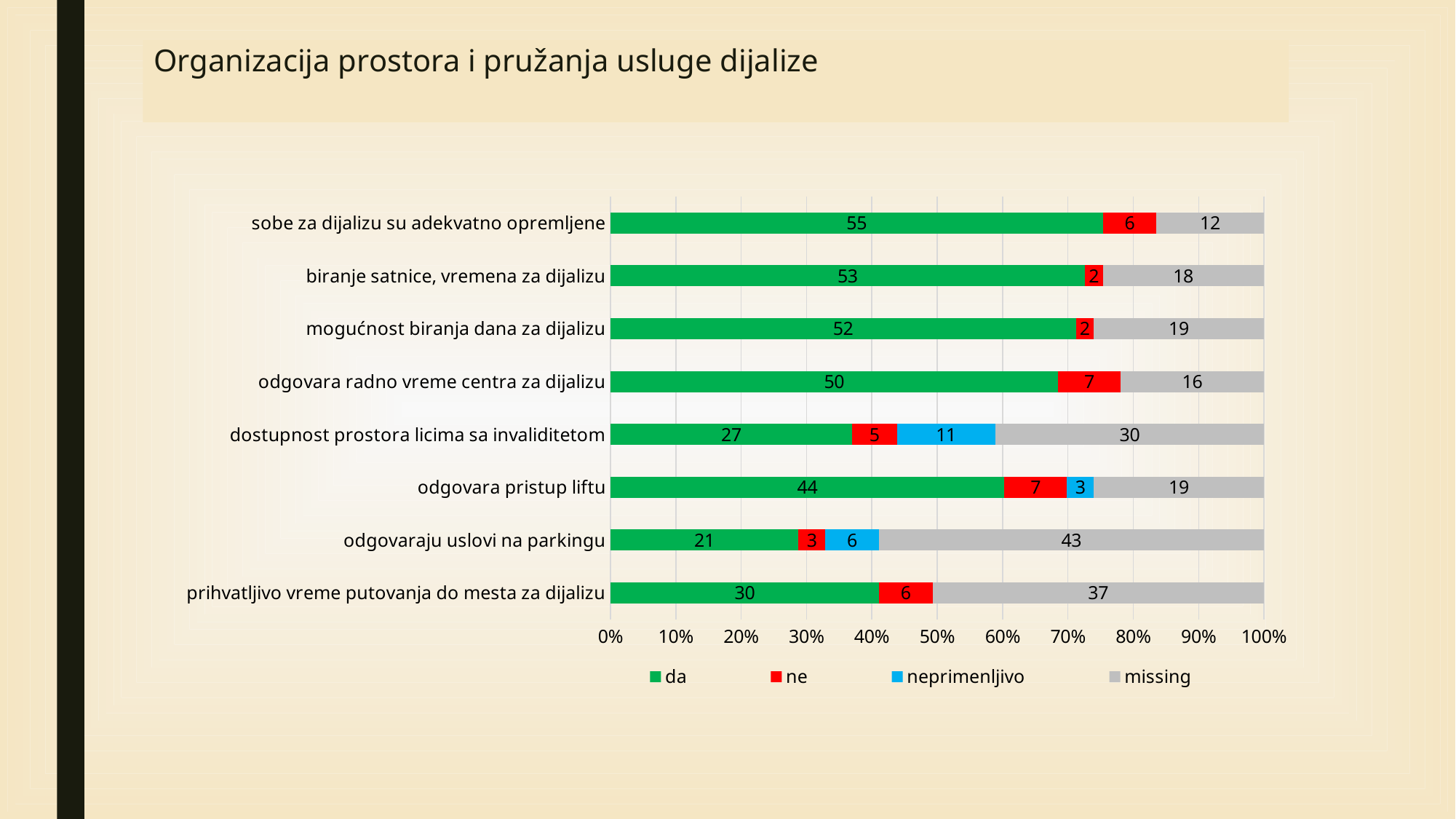
Does the green 'da' segment for 'dostupnost prostora licima sa invaliditetom' end at a share greater or less than 40%? less How many series does the legend list? 4 How many categories are shown on the chart? 8 Which category has the lowest 'da' value? odgovaraju uslovi na parkingu What is the difference between the 'missing' values for 'odgovaraju uslovi na parkingu' and 'prihvatljivo vreme putovanja do mesta za dijalizu'? 6 What kind of chart is shown on the slide? stacked bar chart What is the 'neprimenljivo' value for 'dostupnost prostora licima sa invaliditetom'? 11 What is the sum of the data labels in the bar for 'odgovara pristup liftu'? 73 Which is larger: the 'ne' value for 'odgovara radno vreme centra za dijalizu' or the 'ne' value for 'sobe za dijalizu su adekvatno opremljene'? odgovara radno vreme centra za dijalizu Which category has the highest 'da' value? sobe za dijalizu su adekvatno opremljene What is the 'missing' value for 'odgovaraju uslovi na parkingu'? 43 What is the 'da' value for 'sobe za dijalizu su adekvatno opremljene'? 55